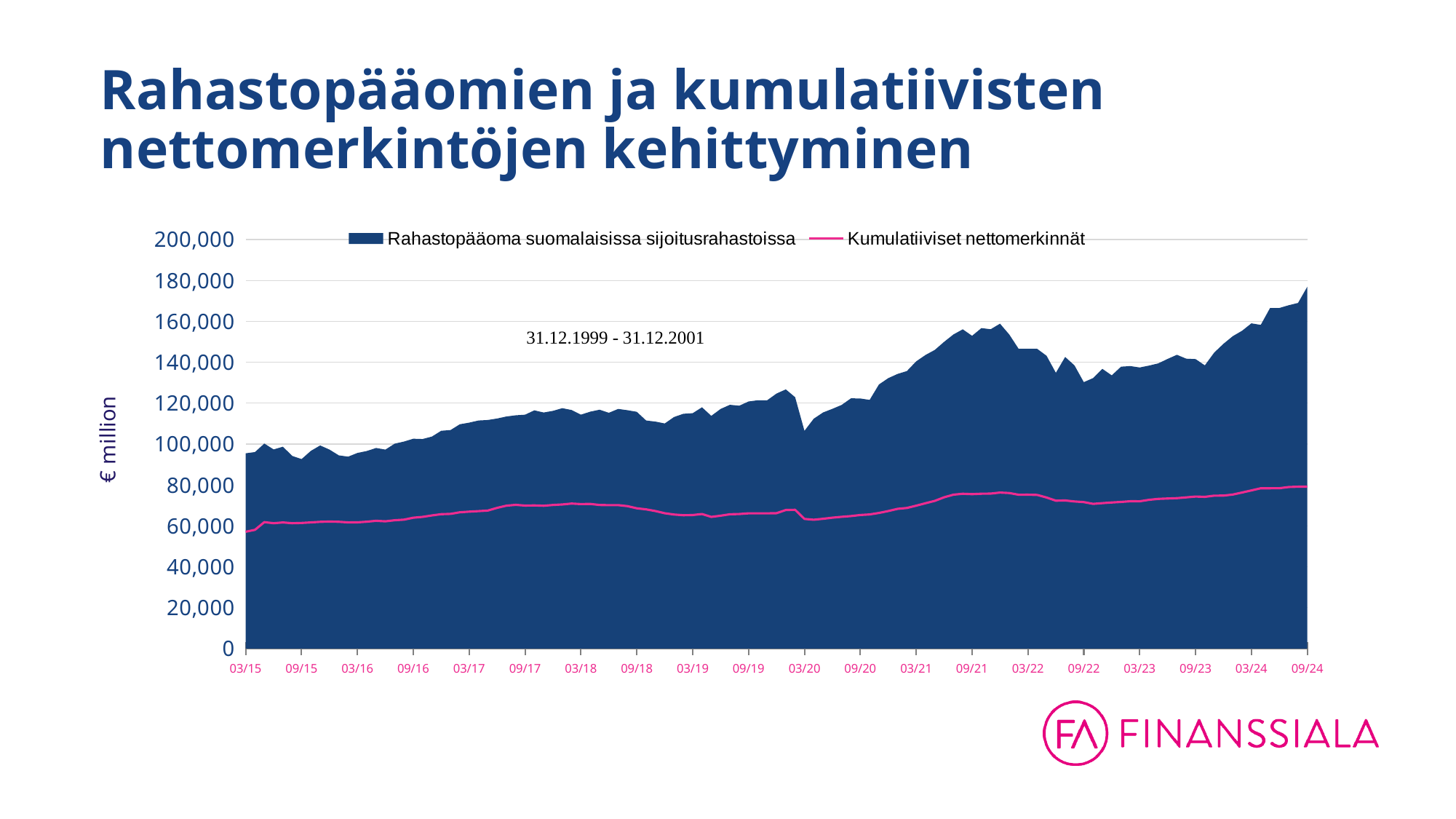
Is the value of Rahastopääoma suomalaisissa sijoitusrahastoissa at 03/20 greater or less than 120,000? less Is the value of Rahastopääoma suomalaisissa sijoitusrahastoissa at 09/24 greater or less than 160,000? greater Which series is drawn as a pink line? Kumulatiiviset nettomerkinnät At which x-axis label does Rahastopääoma suomalaisissa sijoitusrahastoissa reach its highest value? 09/24 How many series does the legend list? 2 At 09/24, which is larger: Rahastopääoma suomalaisissa sijoitusrahastoissa or Kumulatiiviset nettomerkinnät? Rahastopääoma suomalaisissa sijoitusrahastoissa What kind of chart is shown on the slide? area and line chart Is the value of Kumulatiiviset nettomerkinnät at 03/15 greater or less than 60,000? less Does Rahastopääoma suomalaisissa sijoitusrahastoissa overall rise or fall from 03/15 to 09/24? rise What is the unit shown on the vertical axis? € million